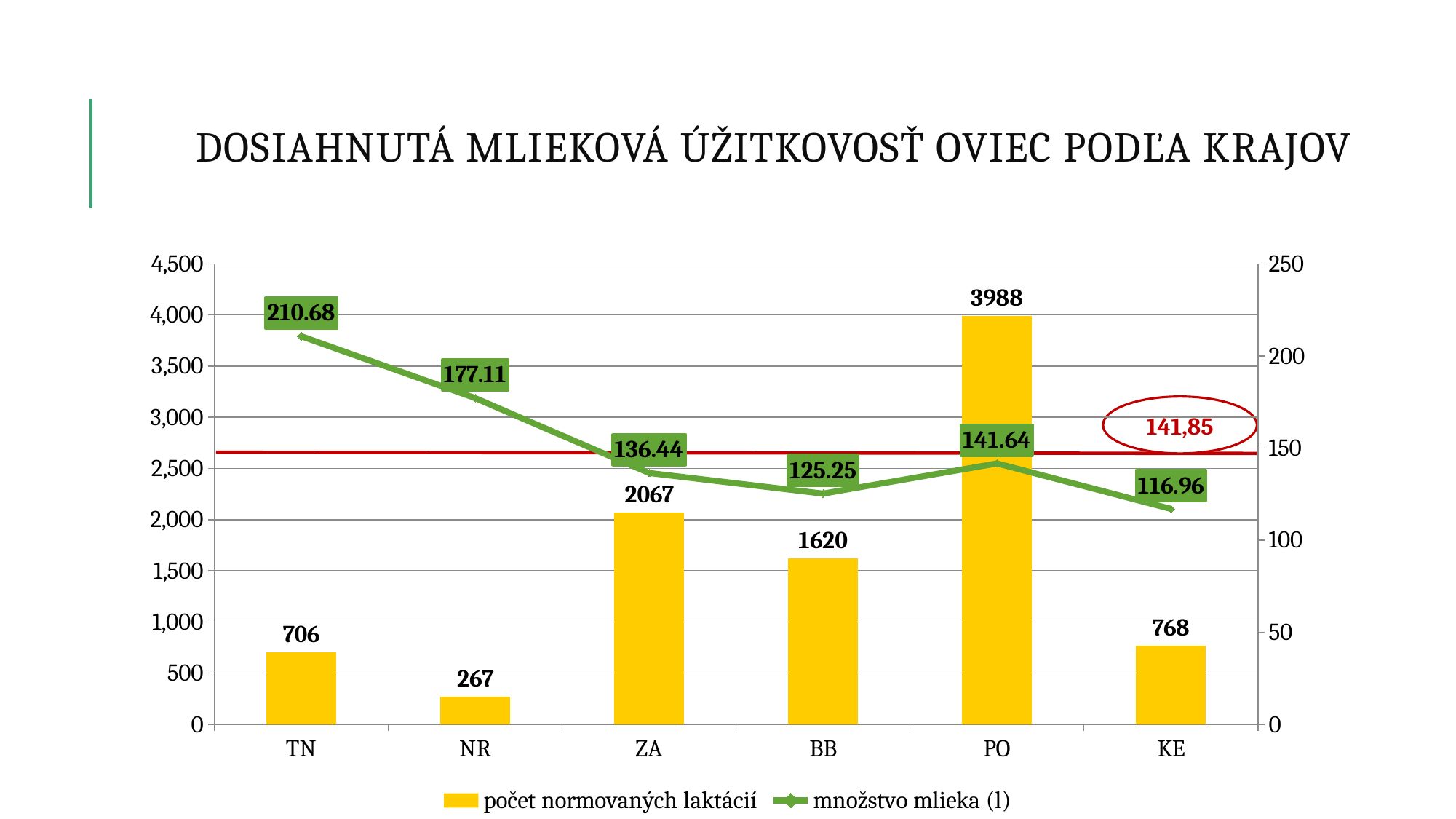
Which is larger, the počet normovaných laktácií for KE or for TN? KE Which region has the highest počet normovaných laktácií? PO How many series does the legend list? 2 What is the value of množstvo mlieka (l) for BB? 125.25 Does the množstvo mlieka (l) line rise or fall from TN to BB? fall What is the value of množstvo mlieka (l) for TN? 210.68 What is the value of počet normovaných laktácií for PO? 3988 How many regions are shown on the x axis? 6 What is the difference in počet normovaných laktácií between PO and ZA? 1921 Which region has the lowest množstvo mlieka (l)? KE What value is written in the red circle next to the horizontal red line? 141,85 Which region has the lowest počet normovaných laktácií? NR